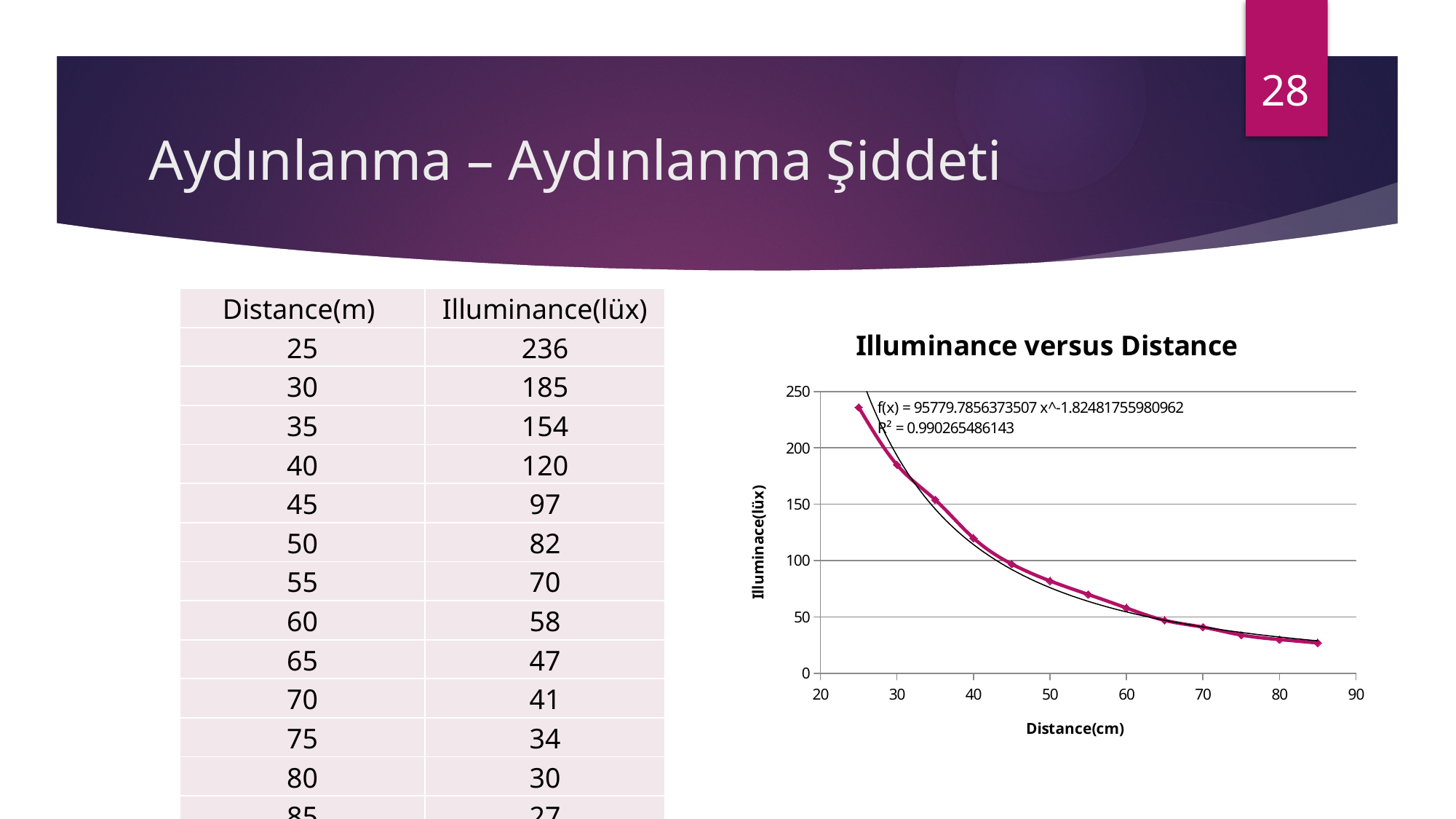
What R² value is printed on the chart? 0.990265486143 What is the title of the chart? Illuminance versus Distance At which distance is the illuminance lowest? 85 Is the illuminance at a distance of 40 greater or less than 100? greater How many data points are plotted on the chart? 13 At which distance is the illuminance highest? 25 Which distance has the larger illuminance, 45 or 55? 45 What is the illuminance at a distance of 50? 82 Do the illuminance values rise or fall as distance increases along the x axis? fall What kind of chart is shown on the slide? line chart Is the illuminance at a distance of 75 greater or less than 50? less What is the difference in illuminance between distances 25 and 30? 51